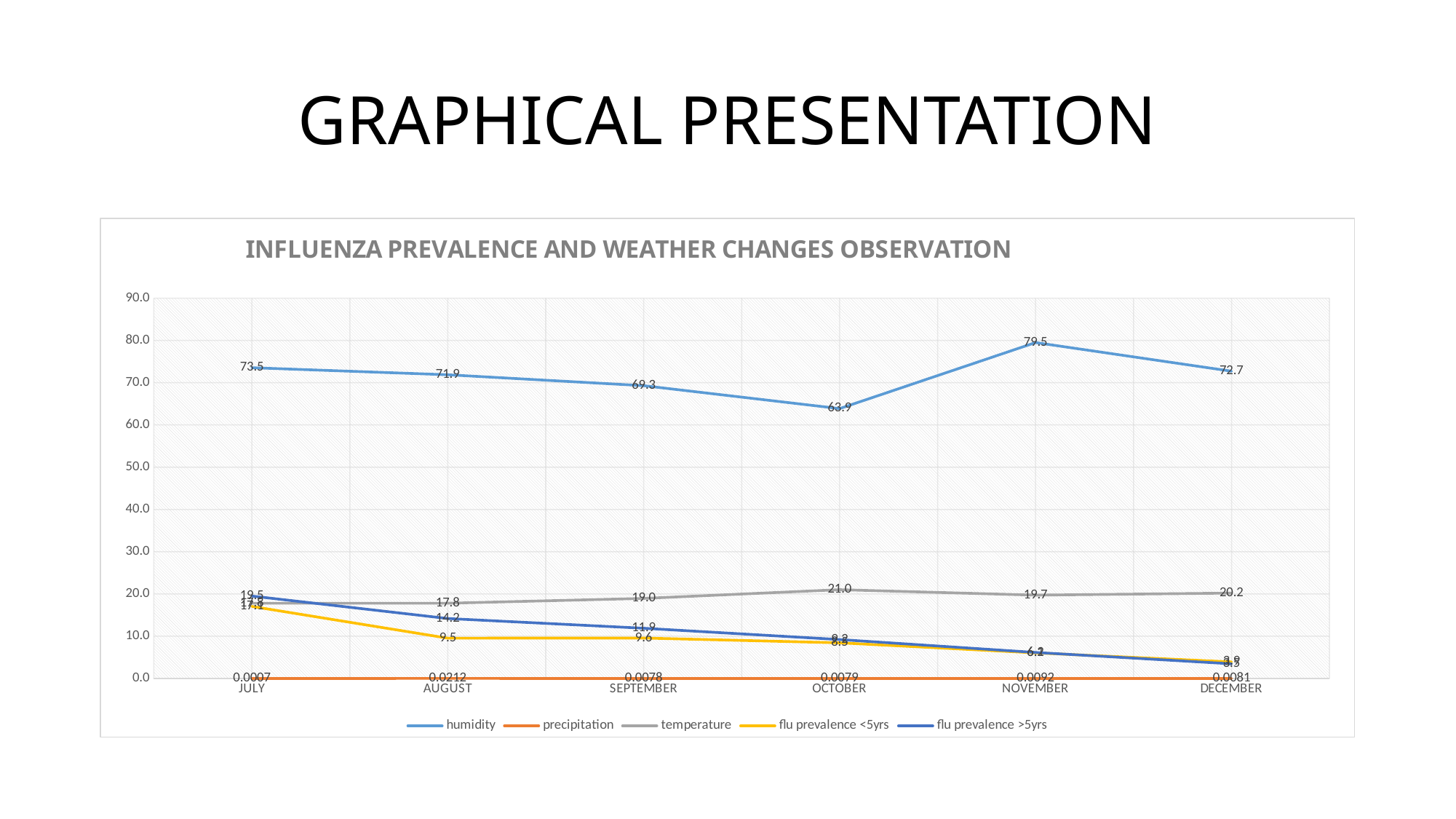
Which is larger, the temperature in October or the temperature in August? October What is the humidity value for July? 73.5 In which month is humidity highest? November Does the flu prevalence >5yrs line rise or fall from July to December? fall What is the flu prevalence >5yrs value for August? 14.2 How many months are plotted along the x axis? 6 In which month is humidity lowest? October What is the precipitation value for August? 0.0212 How many series does the legend list? 5 What is the difference between the humidity in November and the humidity in October? 15.6 What kind of chart is shown on the slide? line chart What is the temperature value for October? 21.0